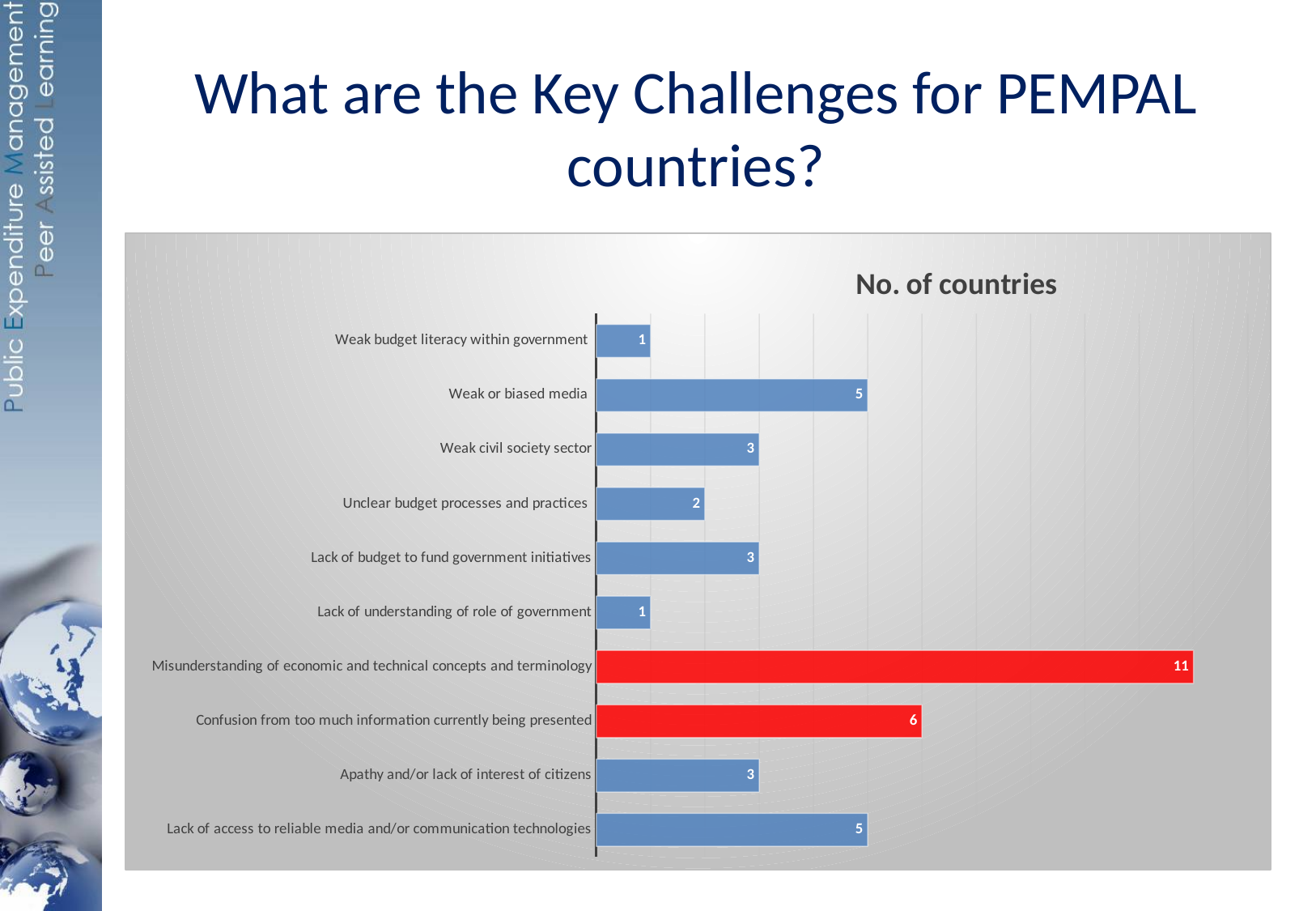
What is the value for 'Unclear budget processes and practices'? 2 What is the value for 'Confusion from too much information currently being presented'? 6 Which two categories are shown with red bars? Misunderstanding of economic and technical concepts and terminology; Confusion from too much information currently being presented Which is larger: the value for 'Weak or biased media' or the value for 'Weak civil society sector'? Weak or biased media What is the difference between the values for 'Lack of access to reliable media and/or communication technologies' and 'Apathy and/or lack of interest of citizens'? 2 What is the difference between the values for 'Misunderstanding of economic and technical concepts and terminology' and 'Confusion from too much information currently being presented'? 5 What is the title of the chart? No. of countries Which category has the highest number of countries? Misunderstanding of economic and technical concepts and terminology What kind of chart is shown on the slide? Bar chart What is the value for 'Weak or biased media'? 5 How many categories are shown in the chart? 10 What is the value for 'Misunderstanding of economic and technical concepts and terminology'? 11